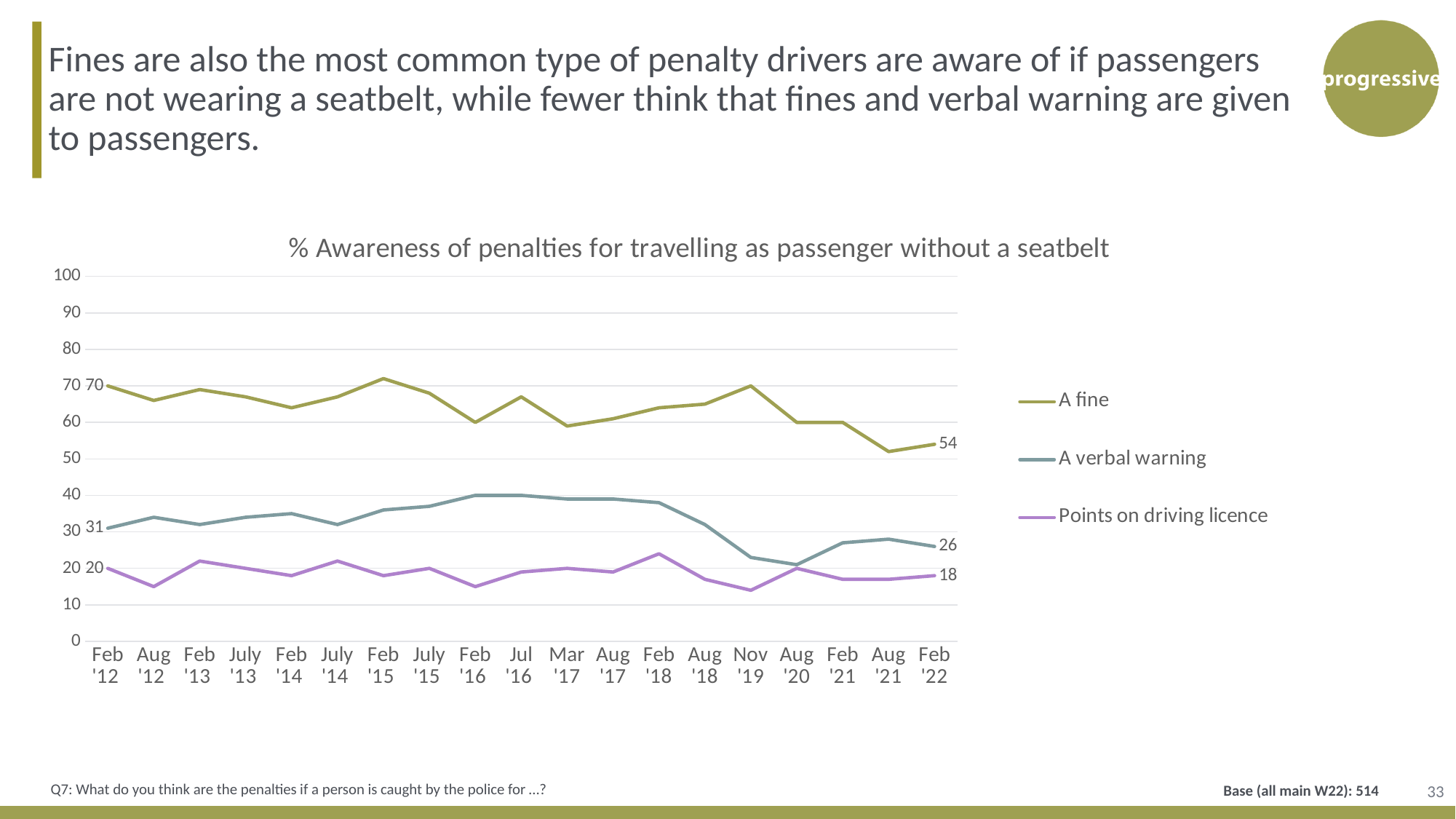
What is the value for 'A fine' in Feb '12? 70 What is the value for 'A fine' in Feb '22? 54 Is the value for 'A fine' in Aug '21 greater or less than 60? less What kind of chart is shown on the slide? line chart By how much did the value for 'A fine' fall between Feb '12 and Feb '22? 16 What is the value for 'Points on driving licence' in Feb '12? 20 How many series does the legend list? 3 In Feb '22, which is larger: 'A fine' or 'A verbal warning'? A fine What is the value for 'A verbal warning' in Feb '22? 26 Is the value for 'A verbal warning' in Nov '19 greater or less than 30? less What is the difference between the 'A verbal warning' values in Feb '12 and Feb '22? 5 How many time points are shown on the x axis? 19